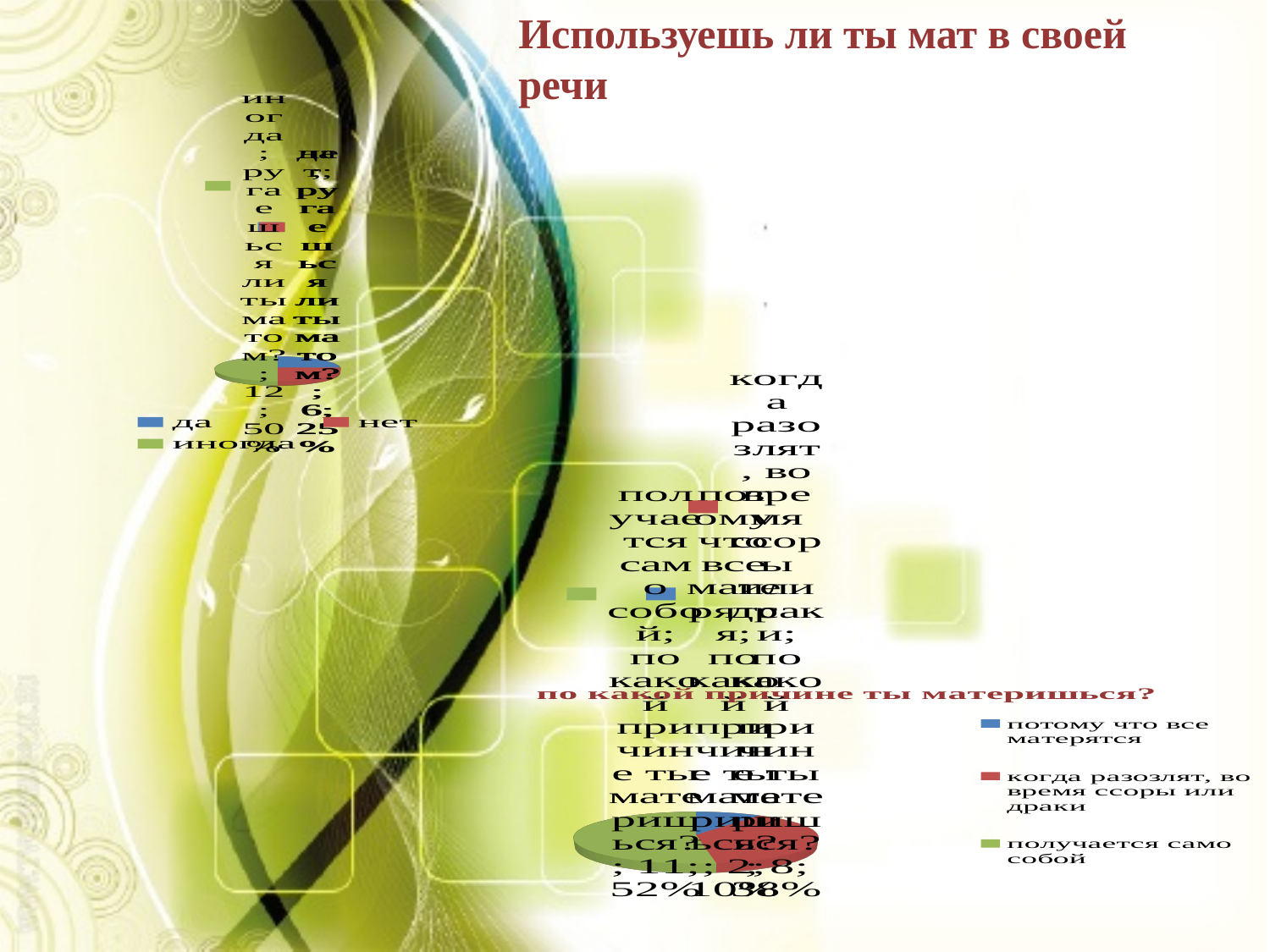
On the chart titled "Используешь ли ты мат в своей речи", what share of the pie is "да"? 25% What kind of chart is the one titled "Используешь ли ты мат в своей речи"? pie chart On the chart titled "Используешь ли ты мат в своей речи", what share of the pie is "иногда"? 50% On the chart titled "по какой причине ты материшься?", which is larger: the share for "получается само собой" or for "когда разозлят, во время ссоры или драки"? получается само собой On the chart titled "по какой причине ты материшься?", what share of the pie is "когда разозлят, во время ссоры или драки"? 38% On the chart titled "по какой причине ты материшься?", what colour is the slice for "получается само собой"? green On the chart titled "по какой причине ты материшься?", which reason has the largest slice? получается само собой On the chart titled "по какой причине ты материшься?", which reason has the smallest slice? потому что все матерятся On the chart titled "Используешь ли ты мат в своей речи", which answer has the largest slice? иногда On the chart titled "Используешь ли ты мат в своей речи", how many entries does the legend list? 3